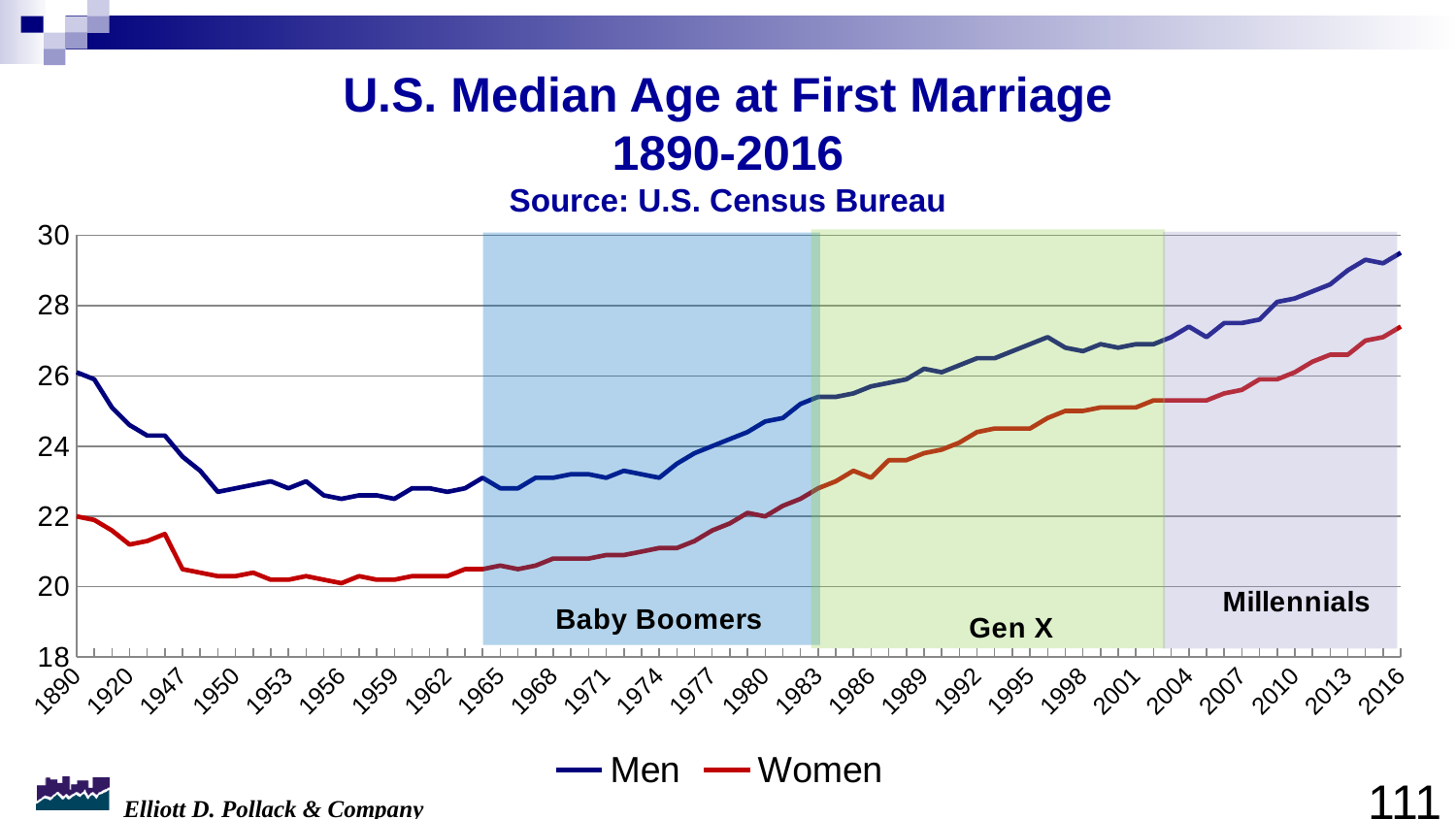
Does the Men series generally rise or fall from 1965 to 2016? Rise In 2016, which series has the higher median age at first marriage, Men or Women? Men Is the value for Women in 2016 greater or less than 26? greater What kind of chart is shown on the slide? Line chart Is the value for Women in 2004 greater or less than 24? greater What are the two series named in the legend? Men and Women Is the value for Women in 1956 greater or less than 22? less Which generation label appears in the rightmost shaded region of the chart? Millennials How many series does the legend list? 2